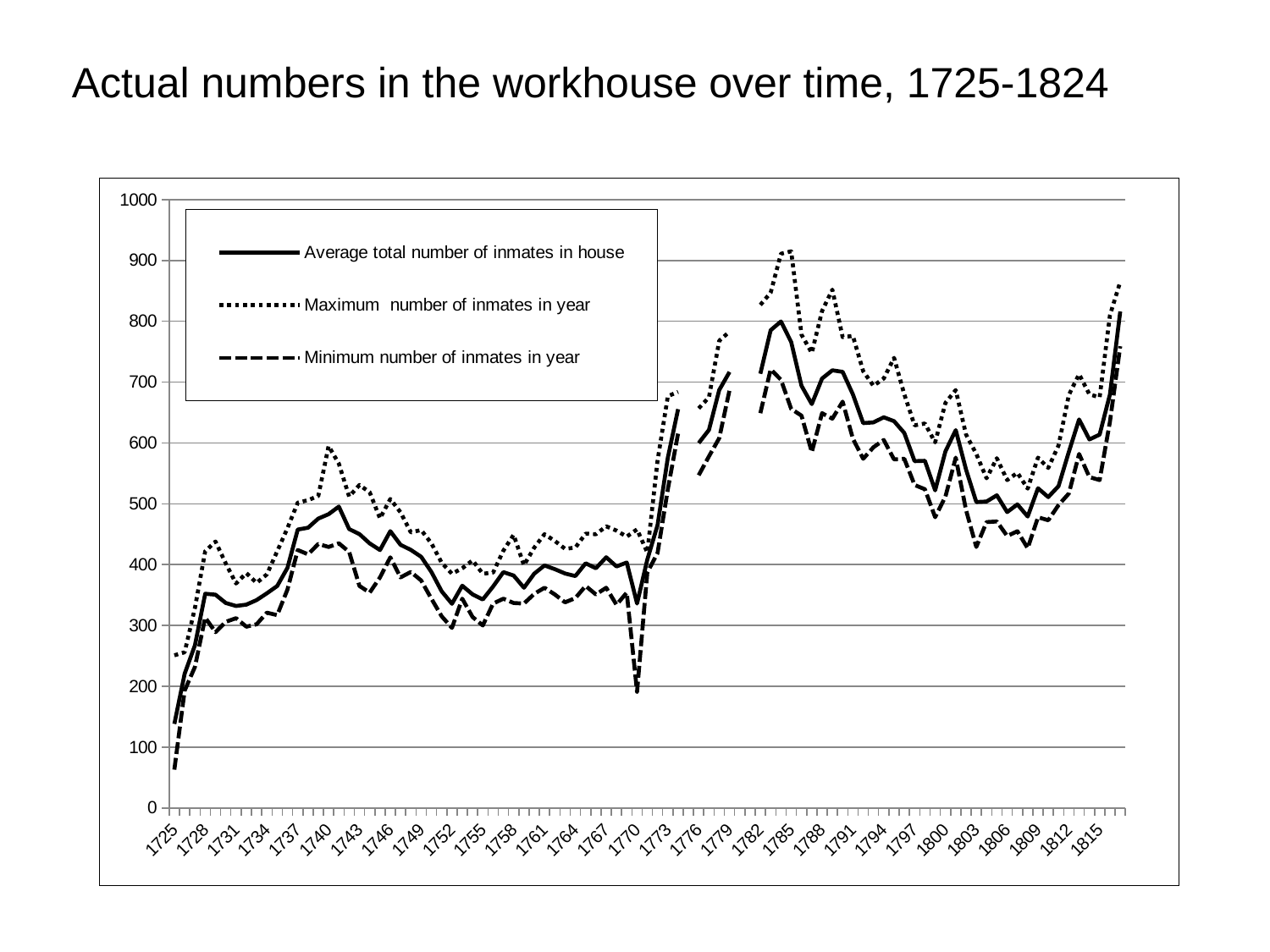
Is the value for Average total number of inmates in house in 1725 greater or less than 100? greater Is the value for Maximum number of inmates in year around 1785 greater or less than 900? greater Which is larger, the Average total number of inmates in house in 1785 or in 1752? 1785 Does the Average total number of inmates in house rise or fall between 1785 and 1803? Fall Is the value for Minimum number of inmates in year in 1725 greater or less than 100? less What kind of chart is shown on the slide? Line chart Does the Average total number of inmates in house rise or fall between 1809 and 1815? Rise How many series does the legend list? 3 What is the title of the slide? Actual numbers in the workhouse over time, 1725-1824 Which series is drawn with a dotted line? Maximum number of inmates in year